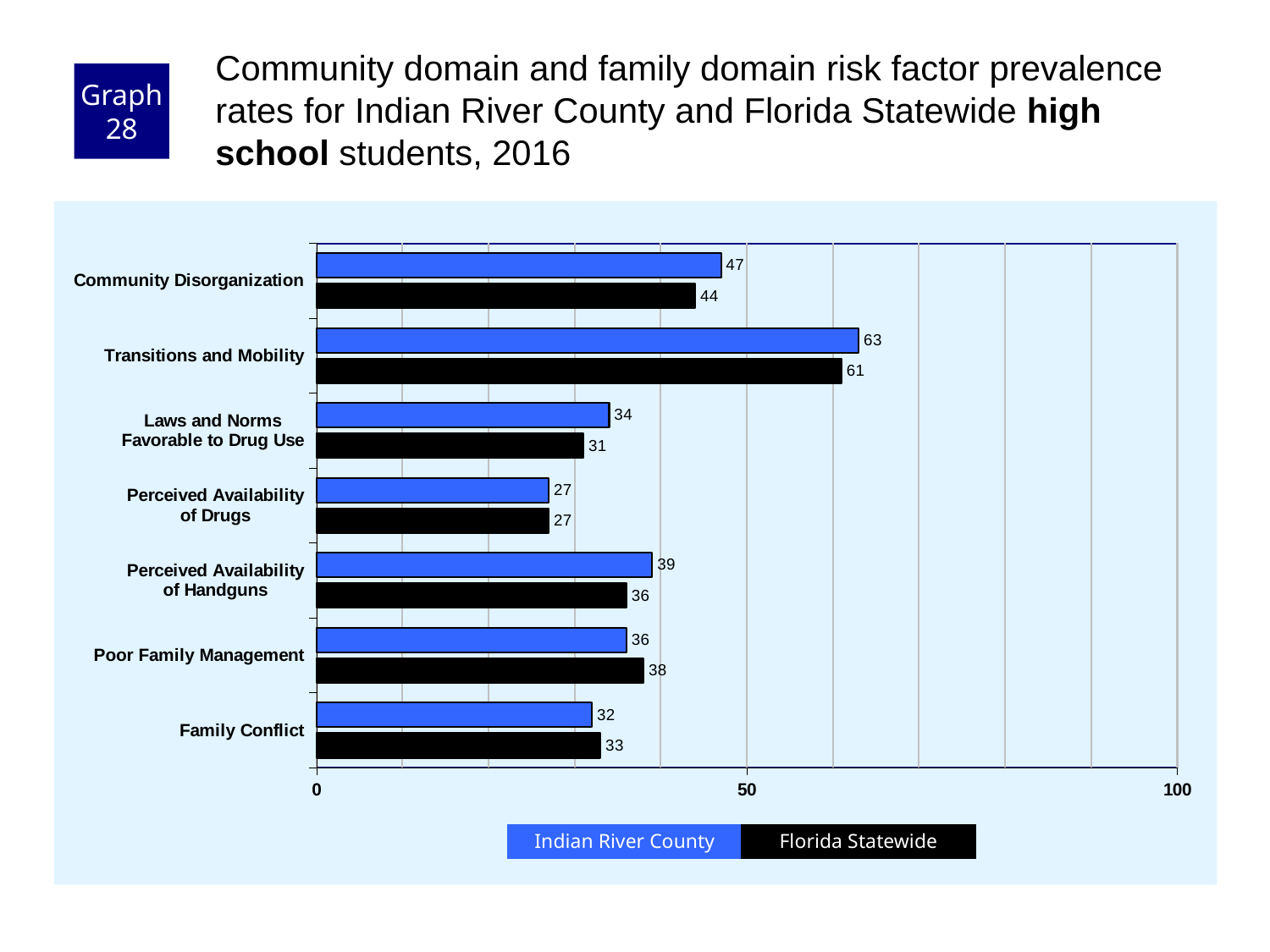
What is the Florida Statewide value for Community Disorganization? 44 How many series does the legend list? 2 Which risk factor has the lowest Florida Statewide value? Perceived Availability of Drugs Which is larger for Perceived Availability of Handguns: Indian River County or Florida Statewide? Indian River County What is the Indian River County value for Transitions and Mobility? 63 Which risk factor has the highest Indian River County value? Transitions and Mobility How many risk factor categories are shown on the chart? 7 What is the difference between the Indian River County and Florida Statewide values for Laws and Norms Favorable to Drug Use? 3 What is the Florida Statewide value for Poor Family Management? 38 Is the Indian River County value for Transitions and Mobility greater or less than 50? greater What kind of chart is shown on the slide? bar chart Which colour represents Florida Statewide in the chart? black